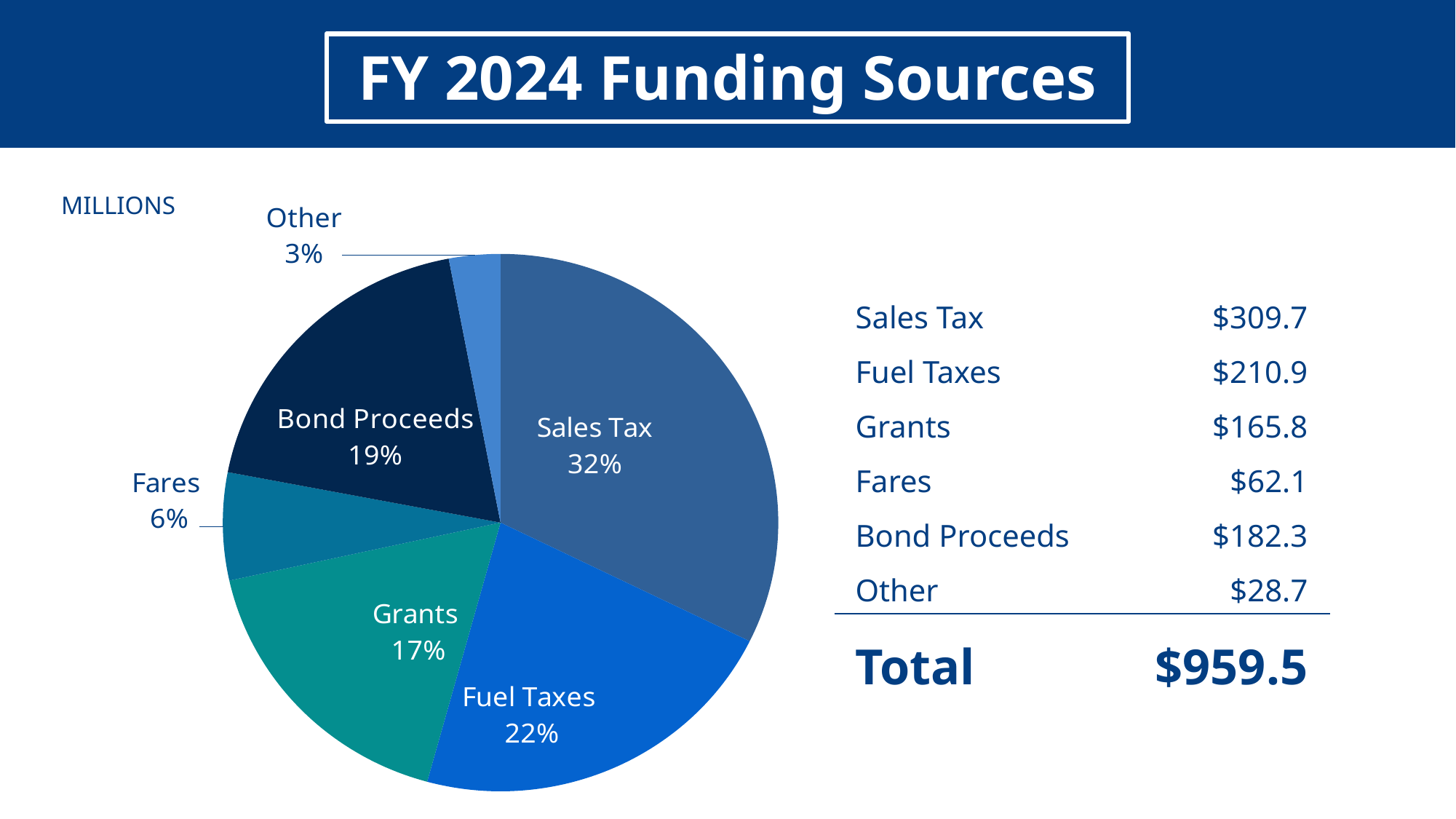
How many funding source categories are shown in the pie chart? 6 Which is larger, Grants or Bond Proceeds? Bond Proceeds What share of the pie does Other represent? 3% What share of the pie does Sales Tax represent? 32% What is the total of all funding sources shown on the slide? $959.5 What is the difference in percentage points between Sales Tax and Fuel Taxes? 10% What is the dollar amount listed for Fares? $62.1 What share of the pie does Bond Proceeds represent? 19% What is the dollar amount listed for Fuel Taxes? $210.9 Which funding source is the largest? Sales Tax What kind of chart is shown on the slide? pie chart Which funding source is the smallest? Other